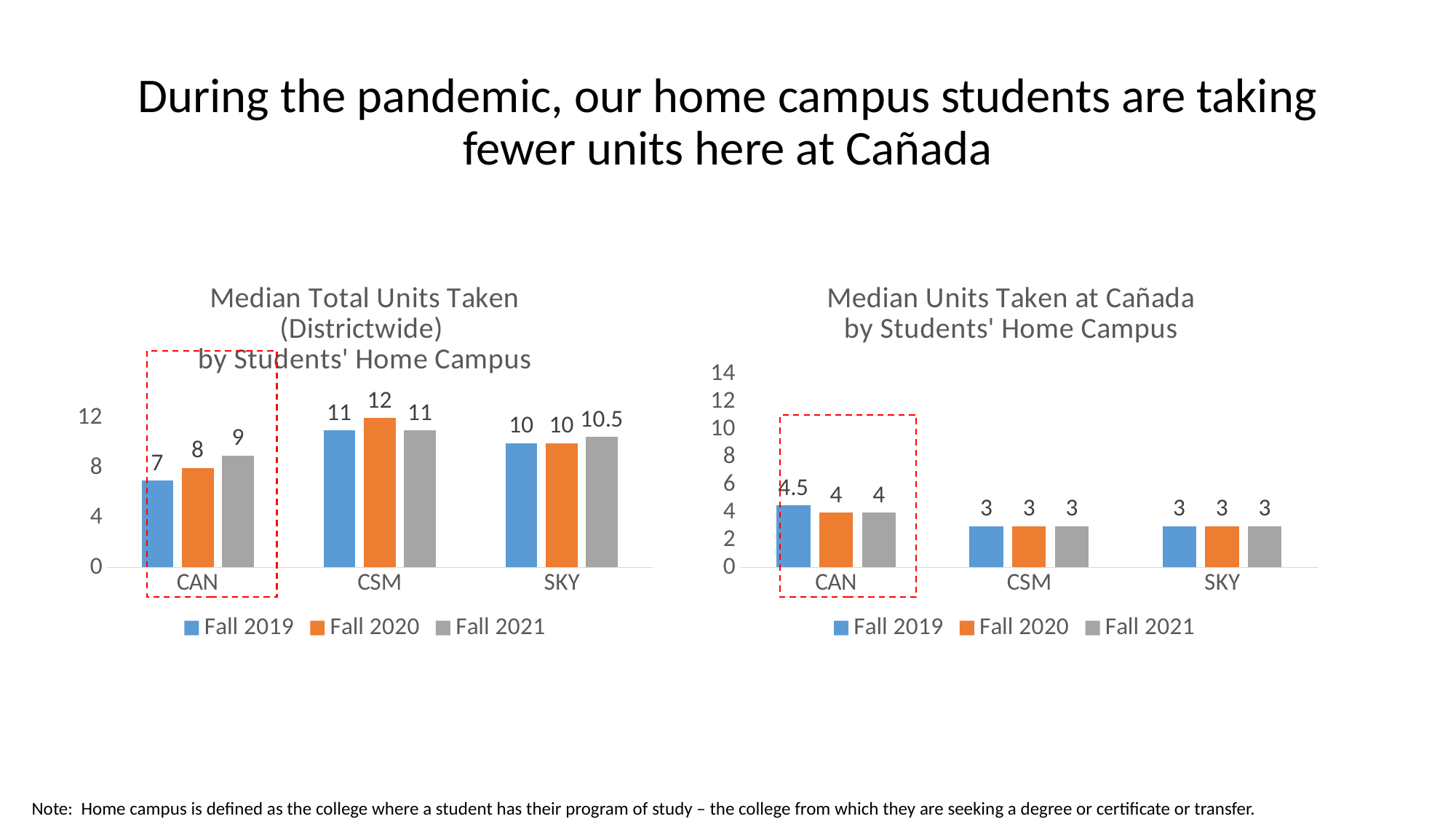
In the 'Median Total Units Taken (Districtwide)' chart, what is the value for SKY in Fall 2021? 10.5 In the 'Median Units Taken at Cañada' chart, what is the value for CSM in Fall 2020? 3 In the 'Median Total Units Taken (Districtwide)' chart, what is the difference between the Fall 2021 and Fall 2019 values for CAN? 2 What kind of chart is the 'Median Units Taken at Cañada by Students' Home Campus' chart? Bar chart In the 'Median Units Taken at Cañada' chart, what is the difference between the Fall 2019 and Fall 2020 values for CAN? 0.5 In the 'Median Total Units Taken (Districtwide)' chart, which campus has the lowest value in Fall 2019? CAN In the 'Median Units Taken at Cañada' chart, what is the value for CAN in Fall 2019? 4.5 In the 'Median Total Units Taken (Districtwide)' chart, which is larger for CSM: Fall 2020 or Fall 2021? Fall 2020 In the 'Median Total Units Taken (Districtwide)' chart, which campus has the highest value in Fall 2020? CSM In the 'Median Total Units Taken (Districtwide)' chart, what is the value for CAN in Fall 2019? 7 How many campus categories are shown on the x axis of the 'Median Total Units Taken (Districtwide)' chart? 3 How many series does the legend list in the 'Median Units Taken at Cañada' chart? 3